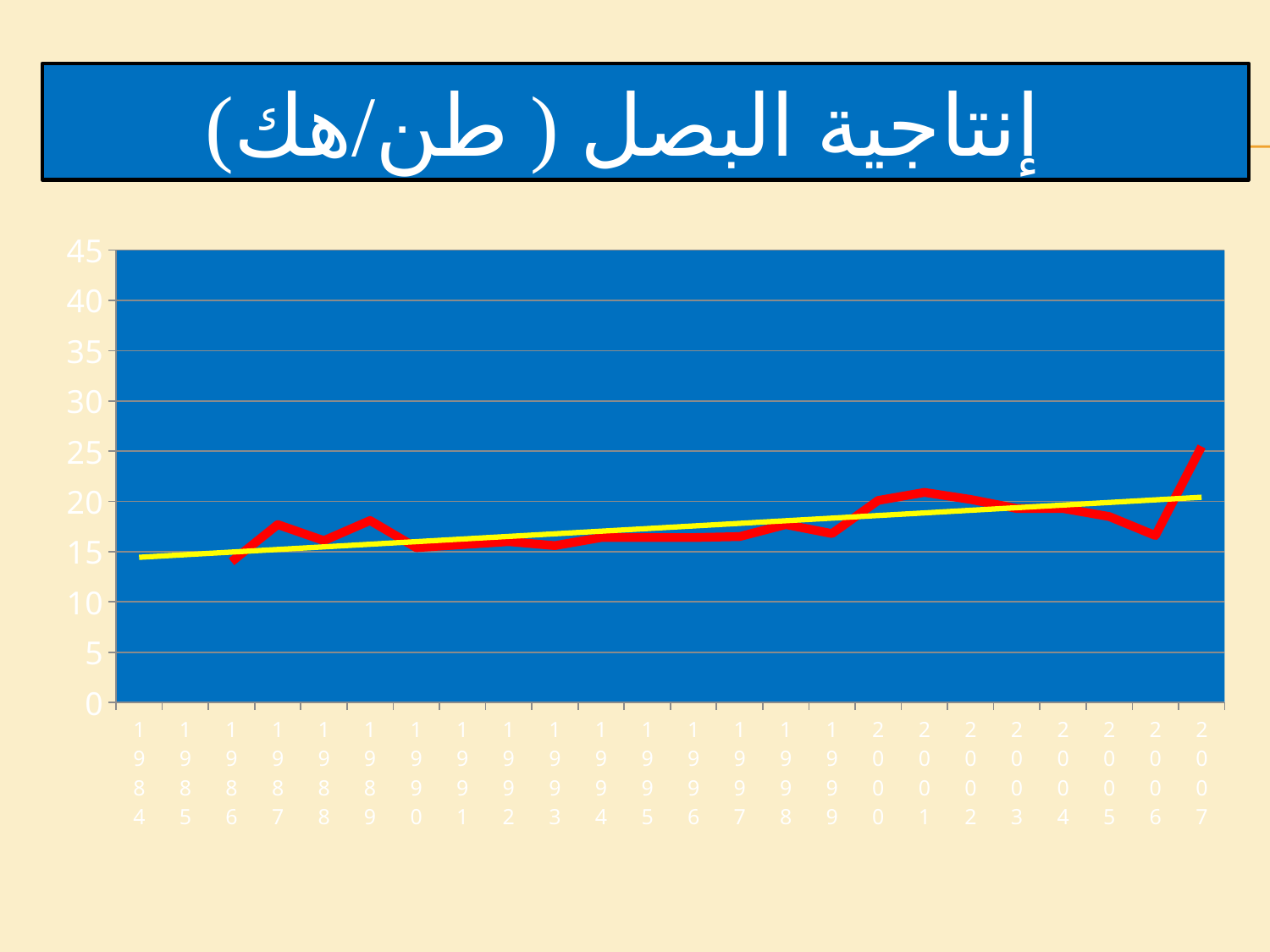
What is the title of the chart? إنتاجية البصل ( طن/هك) Is the value for 1990 greater or less than 20? less What is the first year shown on the x axis? 1984 Which year has the highest value on the red line? 2007 Which is larger, the value for 2001 or the value for 1990? 2001 What kind of chart is shown on the slide? line chart How many years are plotted along the x axis? 24 Is the value for 2001 greater or less than 20? greater Is the value for 2007 greater or less than 20? greater Overall, do the values rise or fall from 1984 to 2007? rise